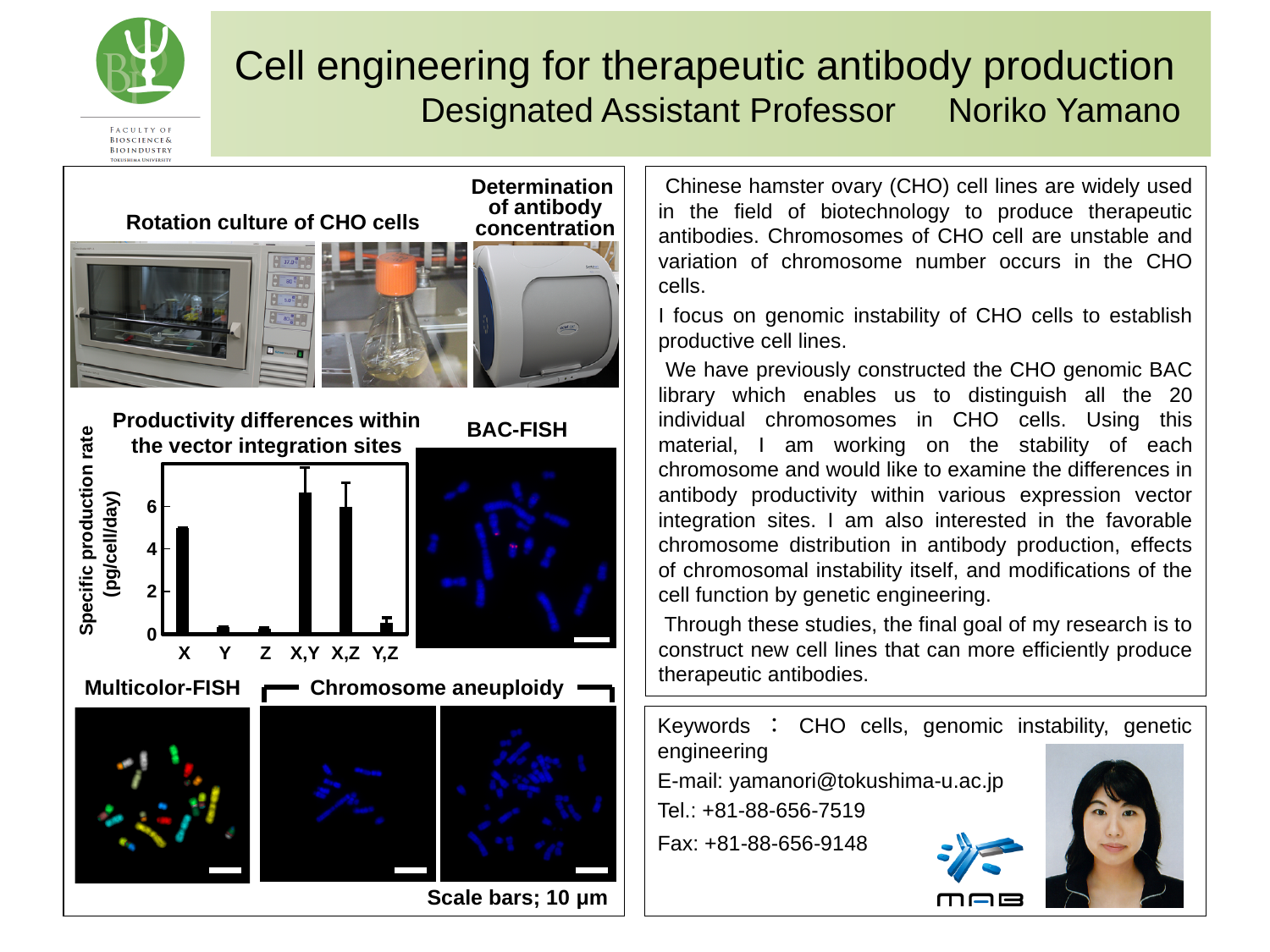
In the productivity bar chart, is the value for X greater or less than 4? greater In the productivity bar chart, which has the higher specific production rate, Z or X,Z? X,Z What is the title of the bar chart on the slide? Productivity differences within the vector integration sites In the productivity bar chart, which has the higher specific production rate, X or Y? X What is the label of the y axis on the productivity bar chart? Specific production rate (pg/cell/day) In the productivity bar chart, is the value for Y,Z greater or less than 2? less In the productivity bar chart, is the value for X,Z greater or less than 4? greater What kind of chart is used to show productivity differences within the vector integration sites? bar chart In the productivity bar chart, which has the higher specific production rate, X or X,Y? X,Y How many vector integration site categories are shown on the x axis of the productivity bar chart? 6